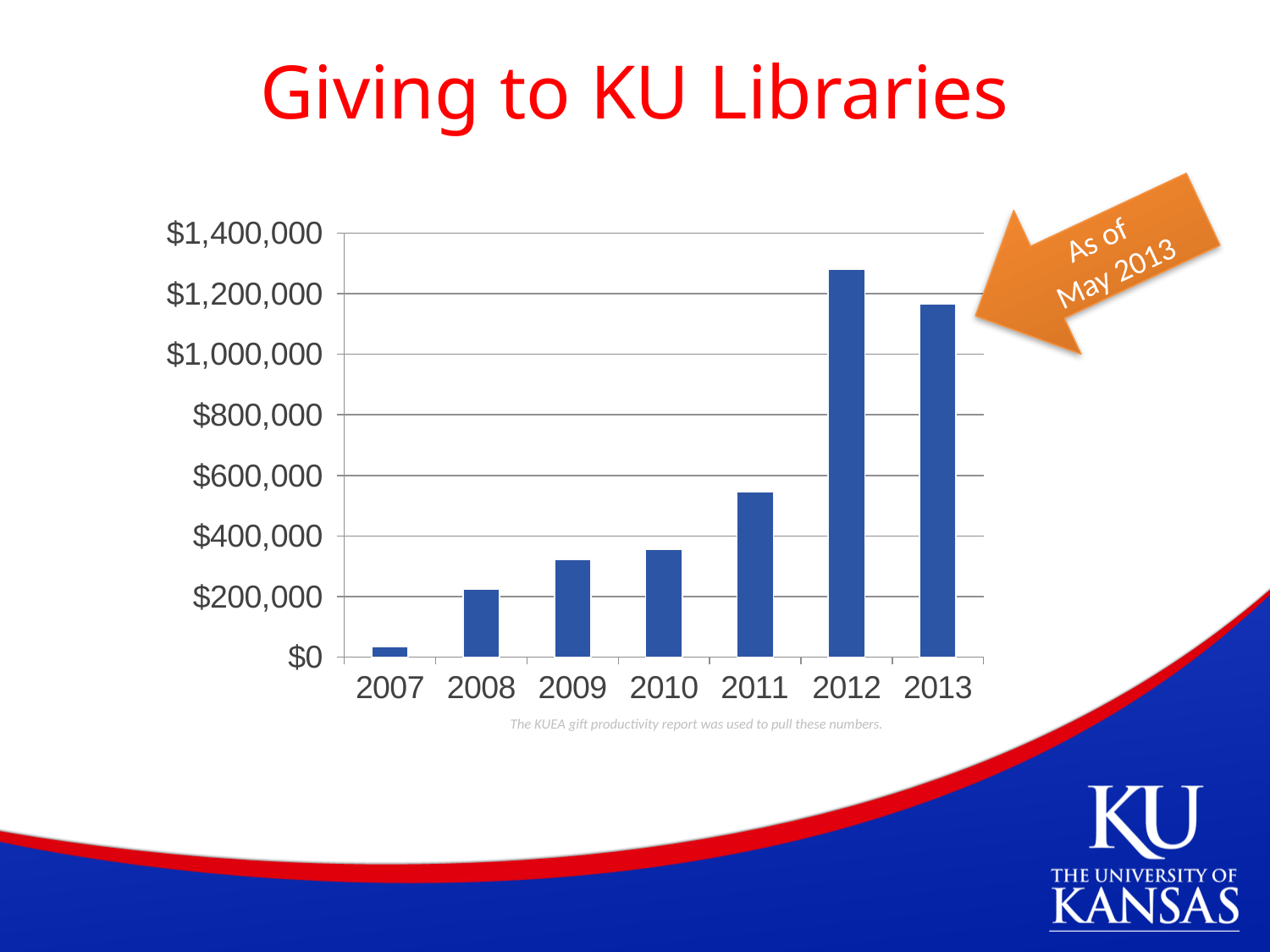
Is the value for 2011 greater or less than $400,000? greater Which year has the lowest giving to KU Libraries? 2007 What is the title of the slide containing the chart? Giving to KU Libraries What kind of chart is shown on the slide? Bar chart Is the value for 2007 greater or less than $200,000? less Which year has the larger value, 2010 or 2011? 2011 Is the value for 2012 greater or less than $1,200,000? greater How many years are shown on the x axis of the chart? 7 Which year has the larger value, 2012 or 2013? 2012 Do the values generally rise or fall from 2007 to 2012? Rise Which year has the highest giving to KU Libraries? 2012